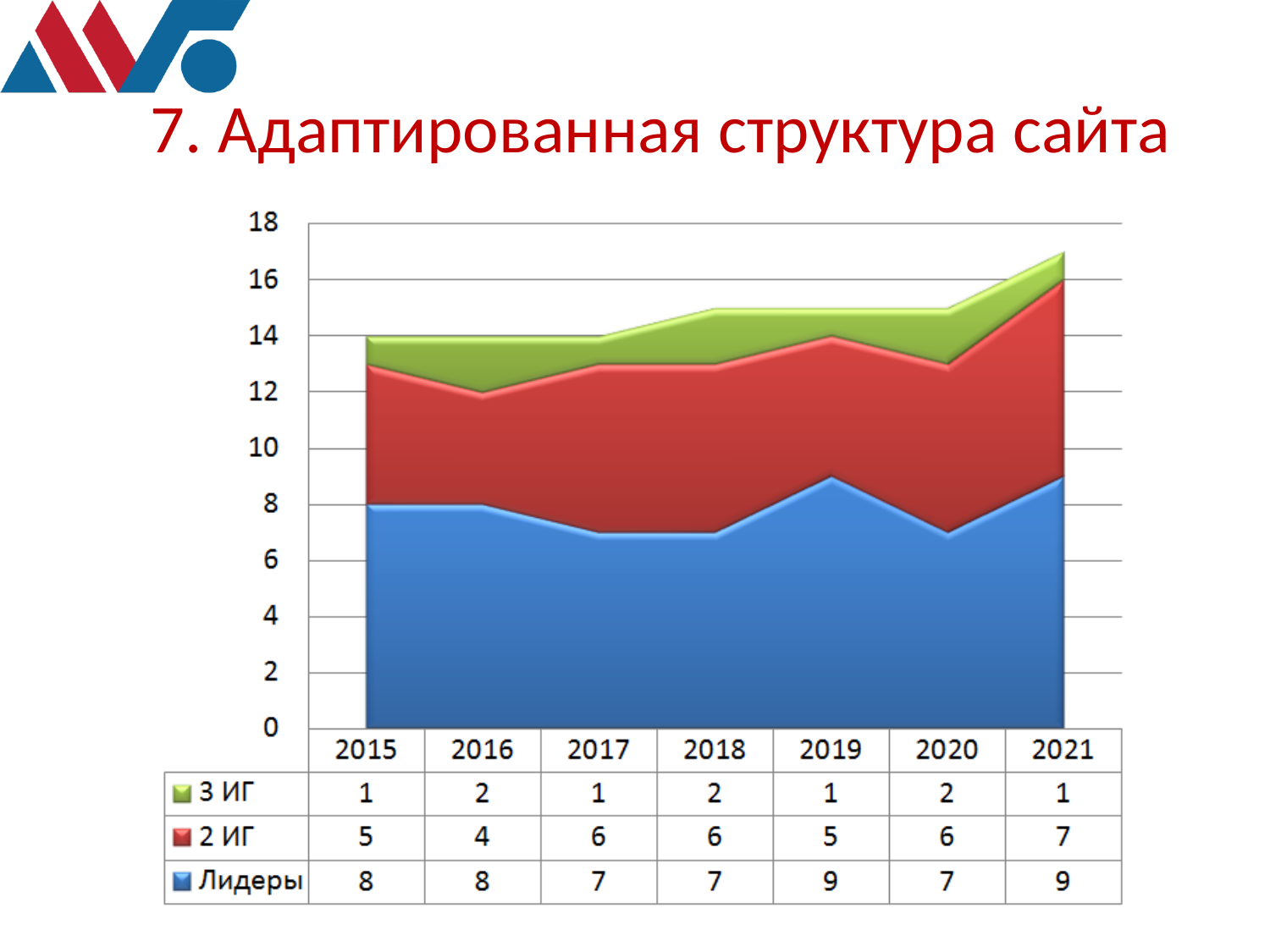
How many series does the legend list? 3 Which is larger: the 2 ИГ value in 2017 or the 2 ИГ value in 2019? 2017 Which series is shown in blue? Лидеры What type of chart is shown on the slide? Stacked area chart What is the total of all three series in 2015? 14 What is the total of all three series in 2021? 17 What is the value for 3 ИГ in 2016? 2 What is the value for 2 ИГ in 2021? 7 In which year is the value for 2 ИГ lowest? 2016 What is the value for Лидеры in 2019? 9 What is the difference between the Лидеры value in 2019 and in 2020? 2 How many years are shown on the x axis? 7